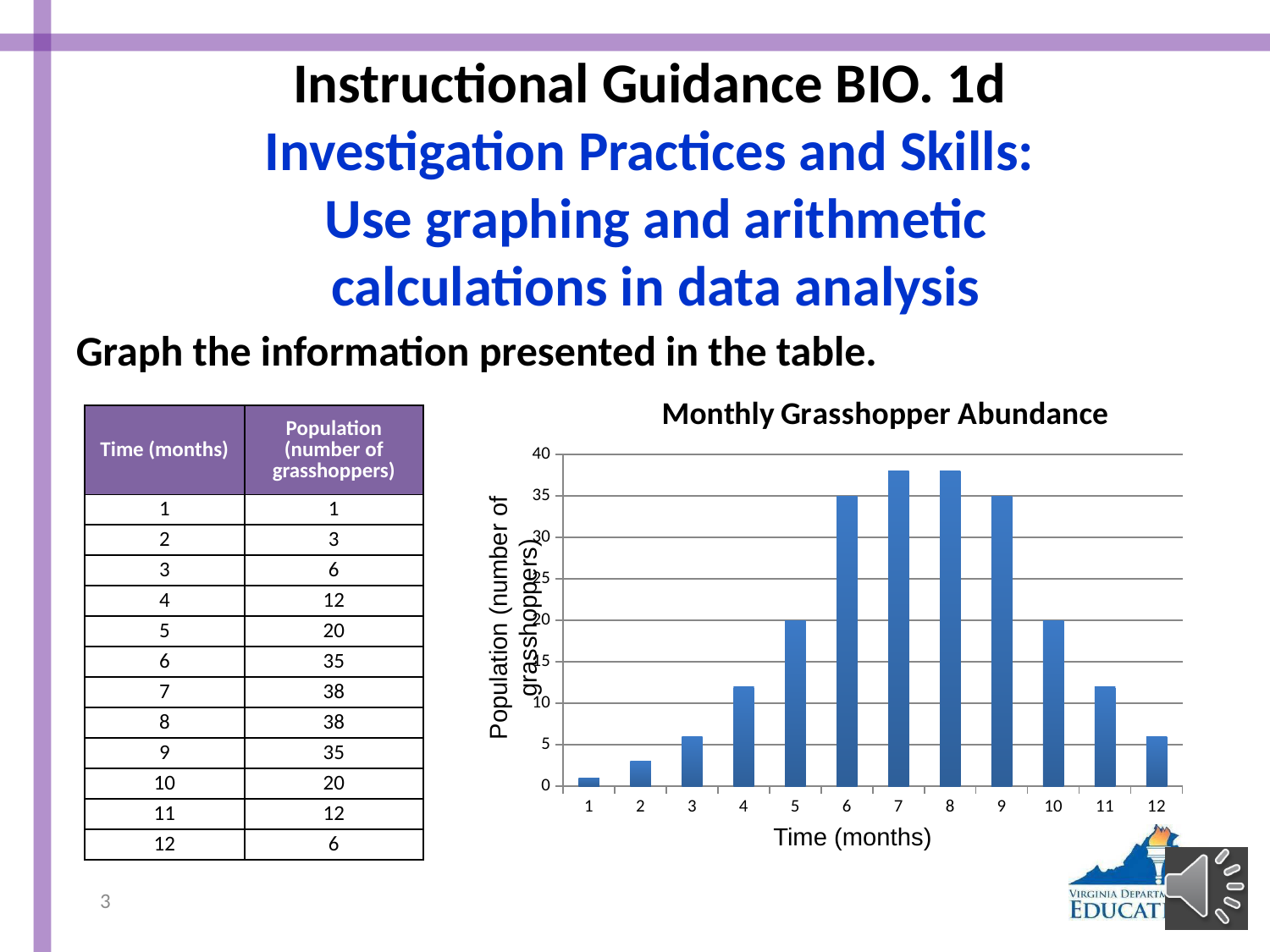
Is the population at month 7 greater or less than 35? greater What is the title of the chart? Monthly Grasshopper Abundance Is the population at month 12 greater or less than 10? less Which is larger, the population at month 3 or at month 10? month 10 What is the population at month 4? 12 What is the population at month 5? 20 What is the population at month 6? 35 What type of chart is shown on the slide? bar chart What is the difference between the population at month 6 and at month 5? 15 Do the values rise or fall from month 8 to month 12? fall How many months (bars) are plotted on the chart? 12 Which month has the lowest population? 1